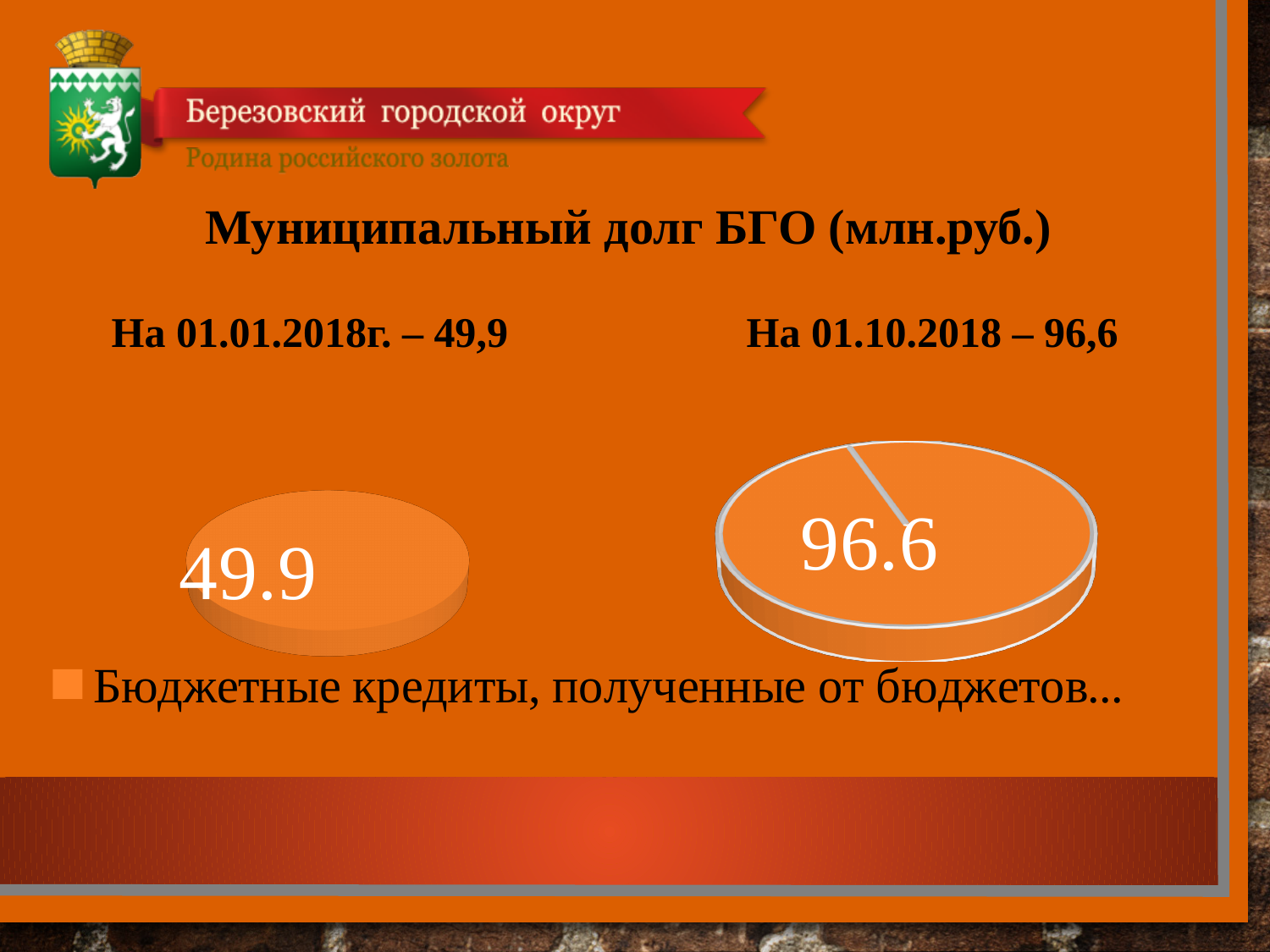
Which date has the lowest municipal debt value shown: 01.01.2018 or 01.10.2018? 01.01.2018 How many entries does the legend below the charts list? 1 What is the title above the charts? Муниципальный долг БГО (млн.руб.) What value is shown on the right pie chart (as of 01.10.2018)? 96.6 What is the difference between the value on the right pie chart (96.6) and the value on the left pie chart (49.9)? 46.7 Which date has the highest municipal debt value shown: 01.01.2018 or 01.10.2018? 01.10.2018 How many pie charts are on the slide? 2 What is the legend entry shown below the pie charts? Бюджетные кредиты, полученные от бюджетов... What kind of charts are shown on the slide? Pie charts Which is larger: the value on the left pie chart (01.01.2018) or the value on the right pie chart (01.10.2018)? The right pie chart (01.10.2018), 96.6 What value is shown on the left pie chart (as of 01.01.2018)? 49.9 Did the municipal debt rise or fall from 01.01.2018 to 01.10.2018 according to the two pie charts? Rise